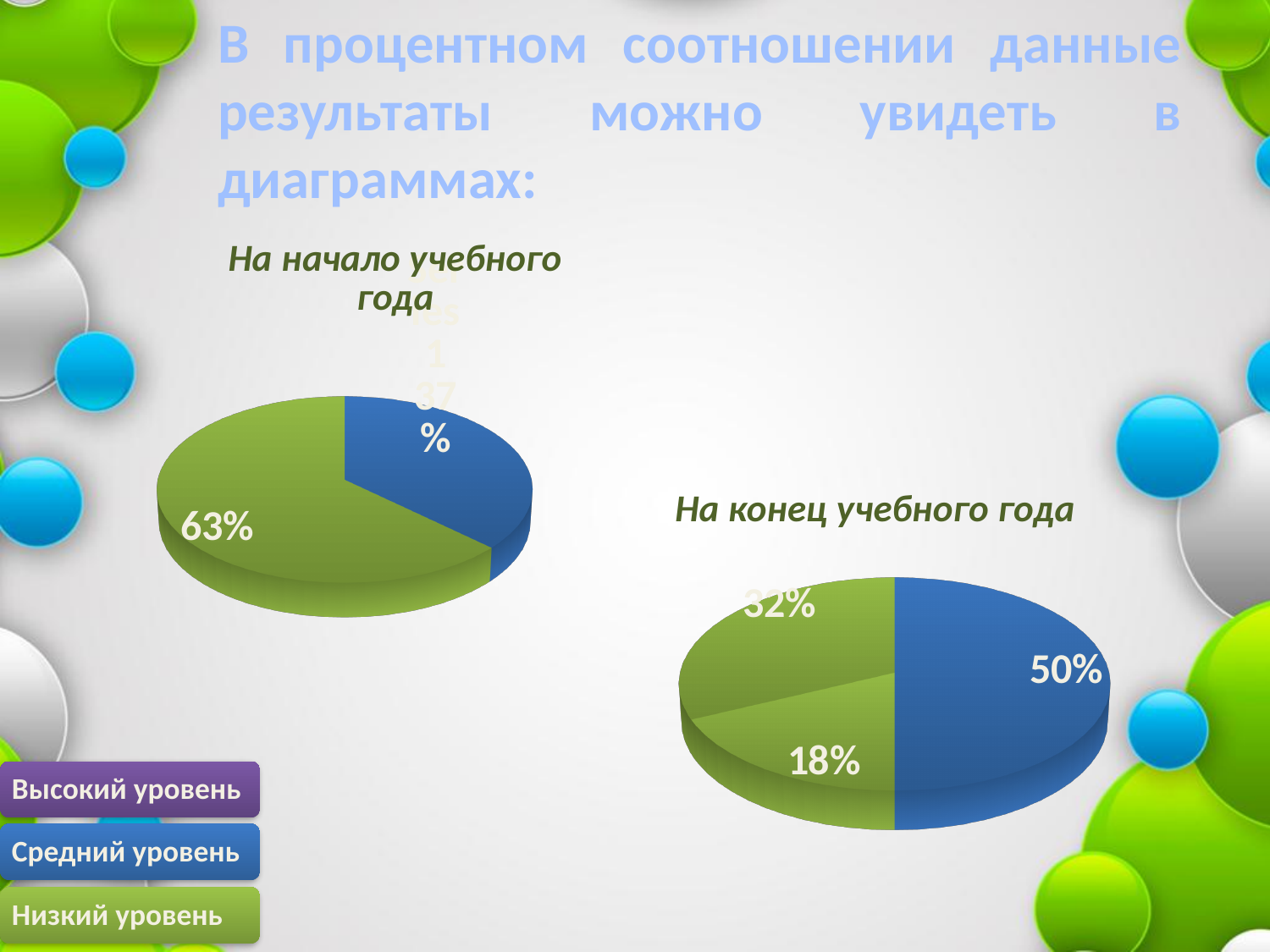
How many slices does the pie chart titled 'На начало учебного года' have? 2 In the pie chart titled 'На конец учебного года', what is the value of the smallest slice? 18% How many entries does the legend at the bottom left of the slide list? 3 In the pie chart titled 'На конец учебного года', what value is shown on the blue slice? 50% Which is larger: the green 63% slice in the 'На начало учебного года' chart or the blue 50% slice in the 'На конец учебного года' chart? The 63% slice in 'На начало учебного года' What is the title of the pie chart on the left side of the slide? На начало учебного года In the pie chart titled 'На конец учебного года', what is the value of the largest slice? 50% In the pie chart titled 'На конец учебного года', what is the difference between the 50% slice and the 18% slice? 32 percentage points In the pie chart titled 'На начало учебного года', what value is shown on the green slice? 63% How many slices does the pie chart titled 'На конец учебного года' have? 3 In the pie chart titled 'На конец учебного года', what is the difference between the 32% slice and the 18% slice? 14 percentage points What kind of charts are shown on the slide? Pie charts